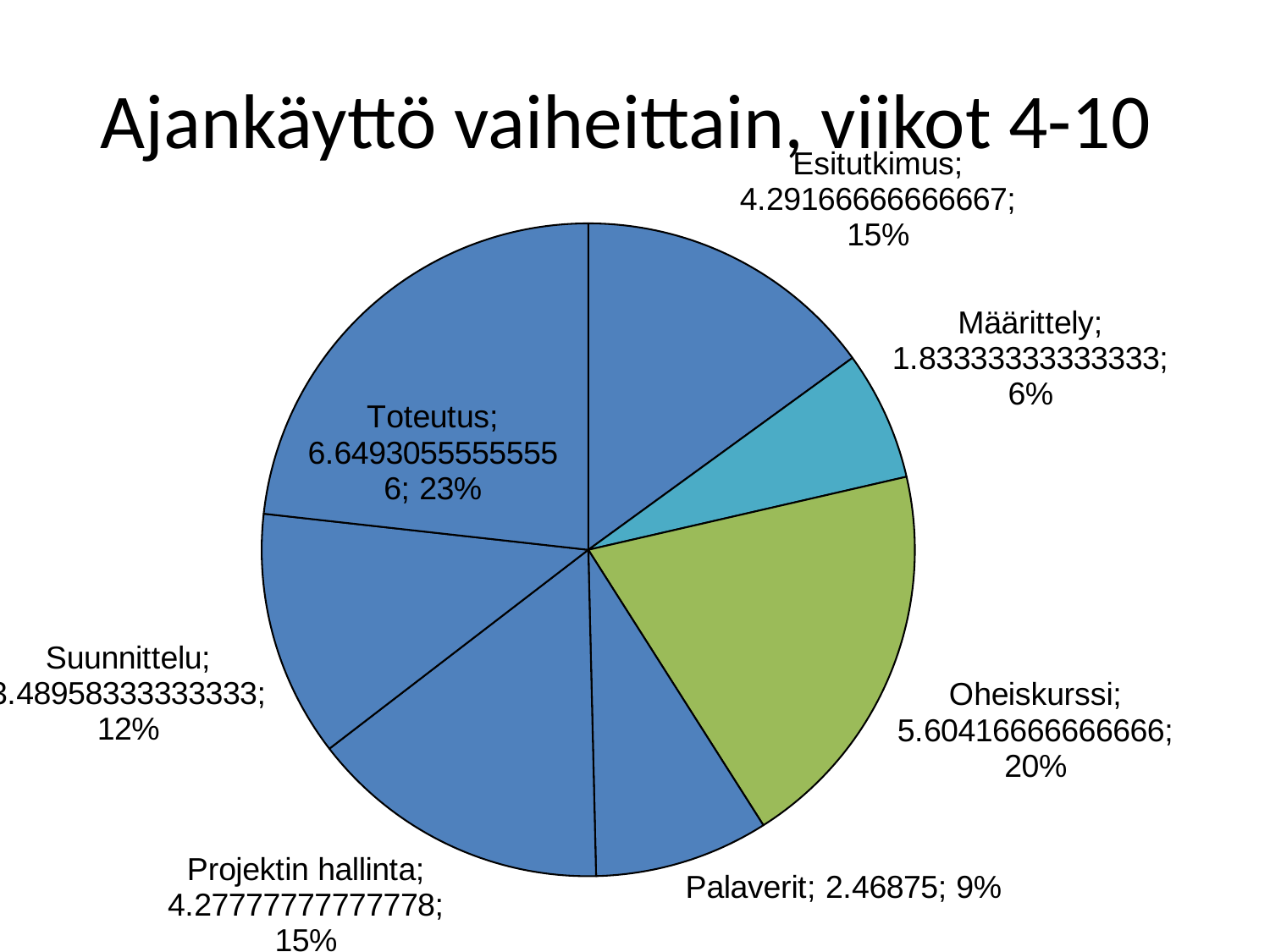
What is the value shown for Esitutkimus? 4.29166666666667 Which category has the largest share of the pie? Toteutus Which is larger, the value for Oheiskurssi or the value for Palaverit? Oheiskurssi How many slices does the pie chart have? 7 What share of the pie does Oheiskurssi represent? 20% What is the value shown for Palaverit? 2.46875 What kind of chart is shown on the slide? pie chart What share of the pie does Suunnittelu represent? 12% What is the title of the chart? Ajankäyttö vaiheittain, viikot 4-10 What is the value shown for Määrittely? 1.83333333333333 What is the difference in percentage share between Toteutus and Oheiskurssi? 3 percentage points Which category has the smallest share of the pie? Määrittely